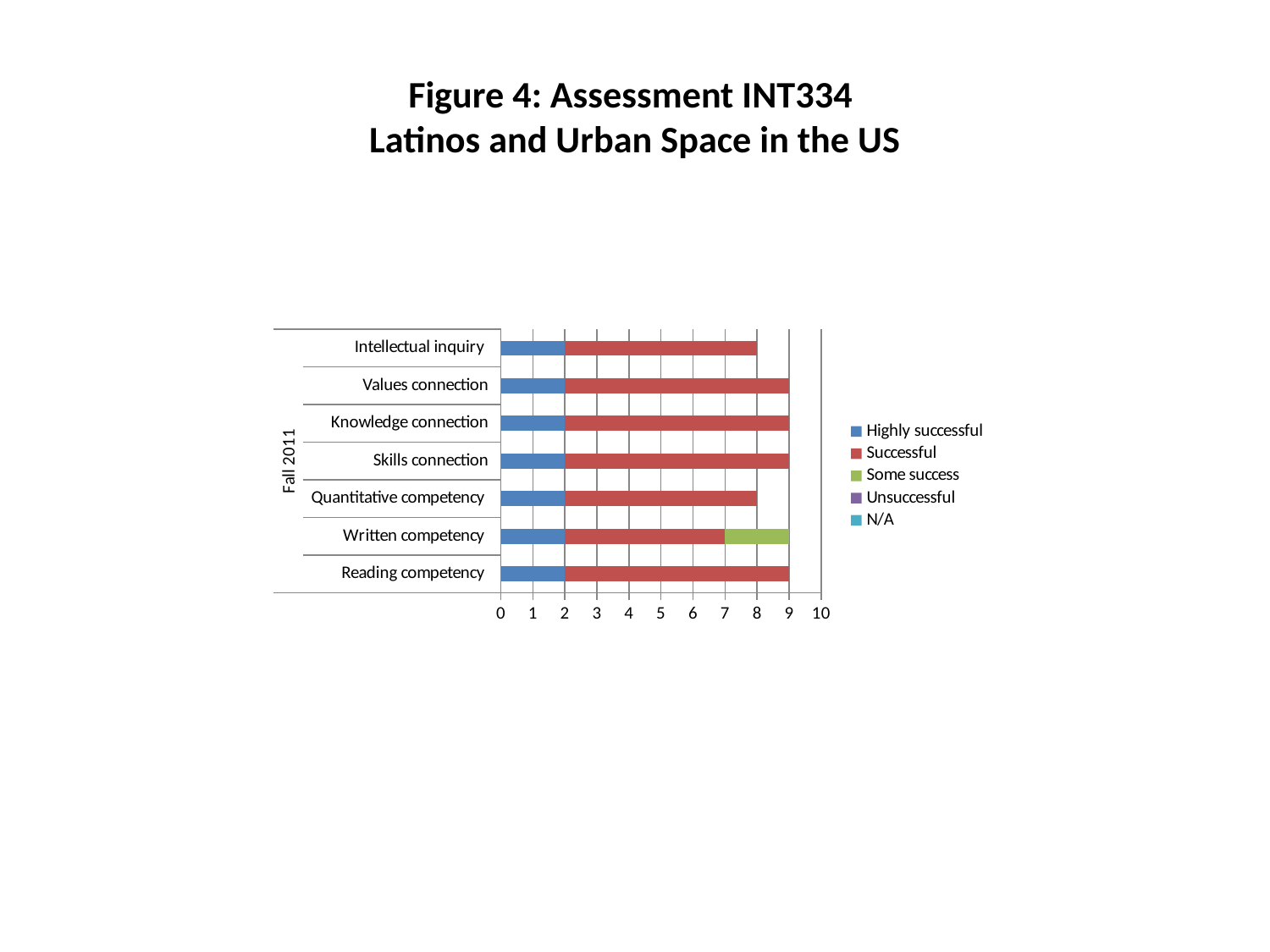
What is the title of the chart on the slide? Figure 4: Assessment INT334 Latinos and Urban Space in the US What is the Highly successful value for Skills connection? 2 How many series does the legend list? 5 Is the total for Quantitative competency greater or less than 5? greater What kind of chart is shown on the slide? bar chart What is the total of the stacked bar for Values connection? 9 What is the Highly successful value for Reading competency? 2 Which is larger, the total bar for Knowledge connection or the total bar for Intellectual inquiry? Knowledge connection Which category is the only one with a Some success segment? Written competency How many categories are plotted on the chart? 7 What is the total of the stacked bar for Written competency? 9 What is the total of the stacked bar for Intellectual inquiry? 8